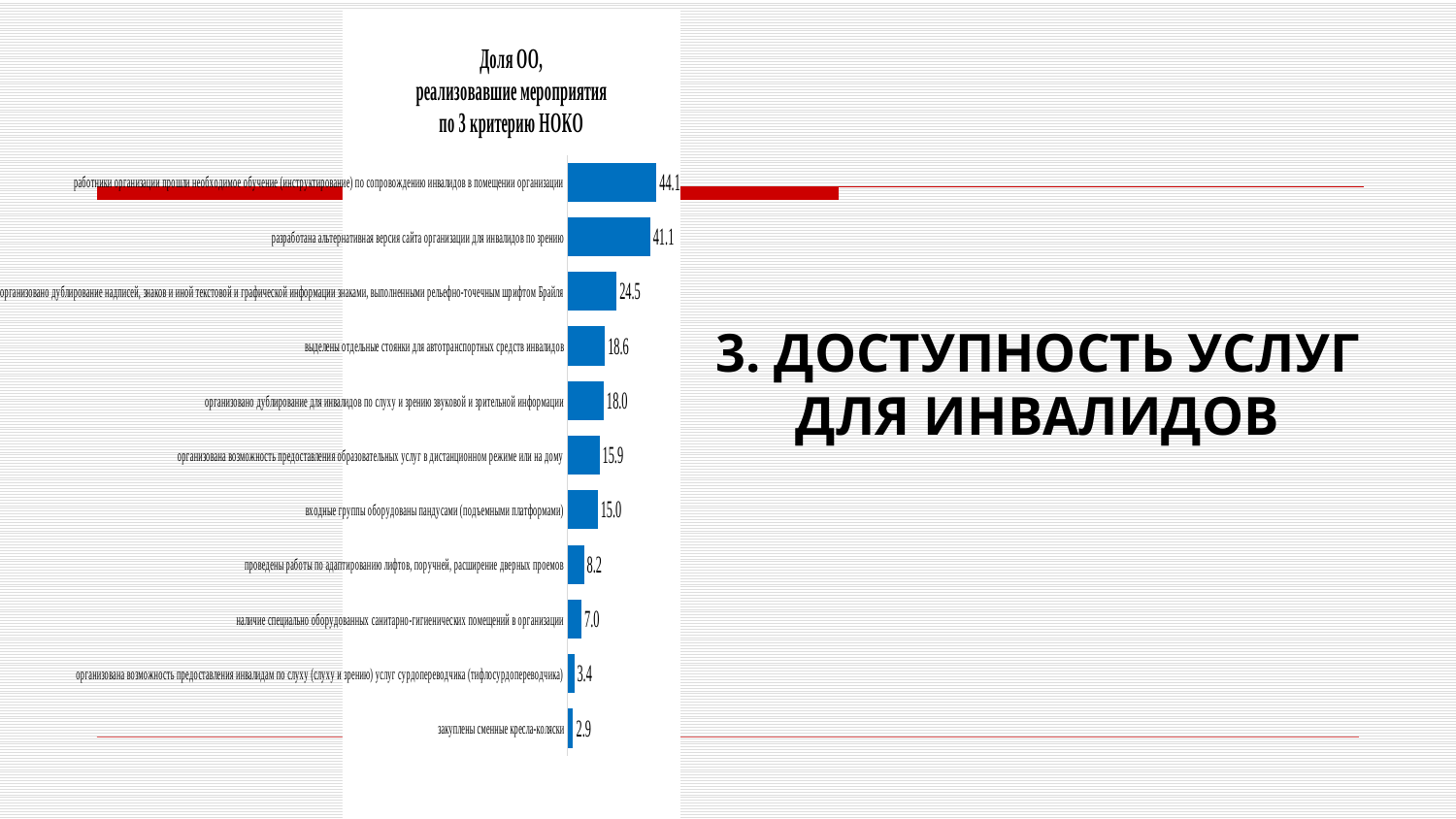
What is the value for "входные группы оборудованы пандусами (подъемными платформами)"? 15.0 Which category has the highest value? работники организации прошли необходимое обучение (инструктирование) по сопровождению инвалидов в помещении организации What is the value for "разработана альтернативная версия сайта организации для инвалидов по зрению"? 41.1 Which is larger: the value for "проведены работы по адаптированию лифтов, поручней, расширение дверных проемов" or for "наличие специально оборудованных санитарно-гигиенических помещений в организации"? проведены работы по адаптированию лифтов, поручней, расширение дверных проемов How many categories are shown in the chart? 11 Which category has the lowest value? закуплены сменные кресла-коляски What is the value for "организовано дублирование для инвалидов по слуху и зрению звуковой и зрительной информации"? 18.0 What is the value for "выделены отдельные стоянки для автотранспортных средств инвалидов"? 18.6 What is the difference between the values for "организована возможность предоставления инвалидам по слуху (слуху и зрению) услуг сурдопереводчика (тифлосурдопереводчика)" and "закуплены сменные кресла-коляски"? 0.5 What is the title of the chart? Доля ОО, реализовавшие мероприятия по 3 критерию НОКО What is the difference between the values for "работники организации прошли необходимое обучение (инструктирование) по сопровождению инвалидов в помещении организации" and "разработана альтернативная версия сайта организации для инвалидов по зрению"? 3.0 What kind of chart is shown on the slide? bar chart